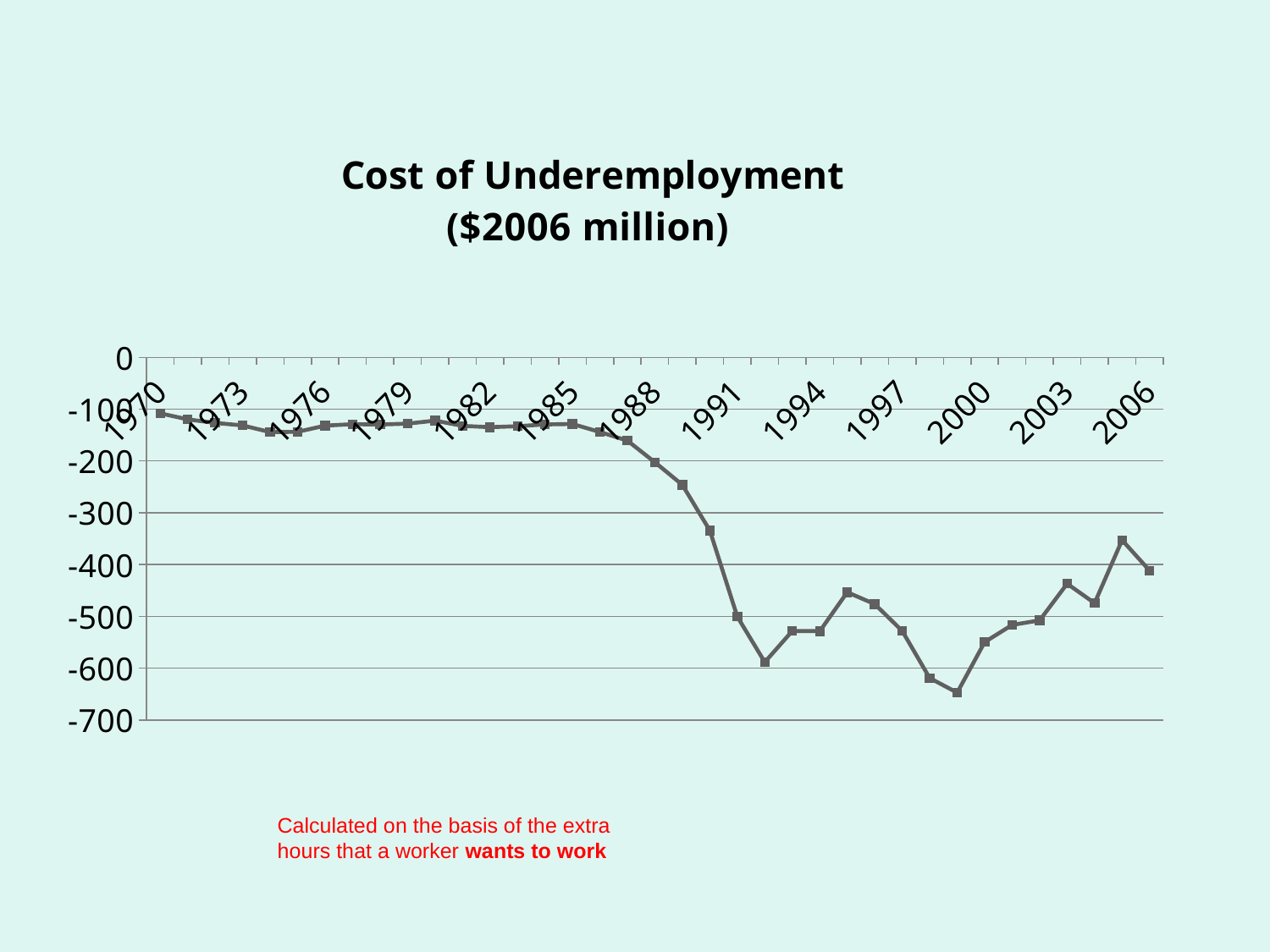
Overall, do the values rise or fall from 1970 to 2006? fall What is the title of the chart? Cost of Underemployment ($2006 million) Is the value for 2000 above or below -500 on the axis? below Is the value for 2006 above or below -500 on the axis? above What kind of chart is shown on the slide? line chart Is the value for 2003 above or below -500 on the axis? above Do the values rise or fall between 1985 and 1991? fall Which year has the higher value, 1988 or 1991? 1988 What is the lowest value shown on the y axis of the chart? -700 How many years are labeled on the x axis of the chart? 13 Which year has the higher value, 2000 or 2006? 2006